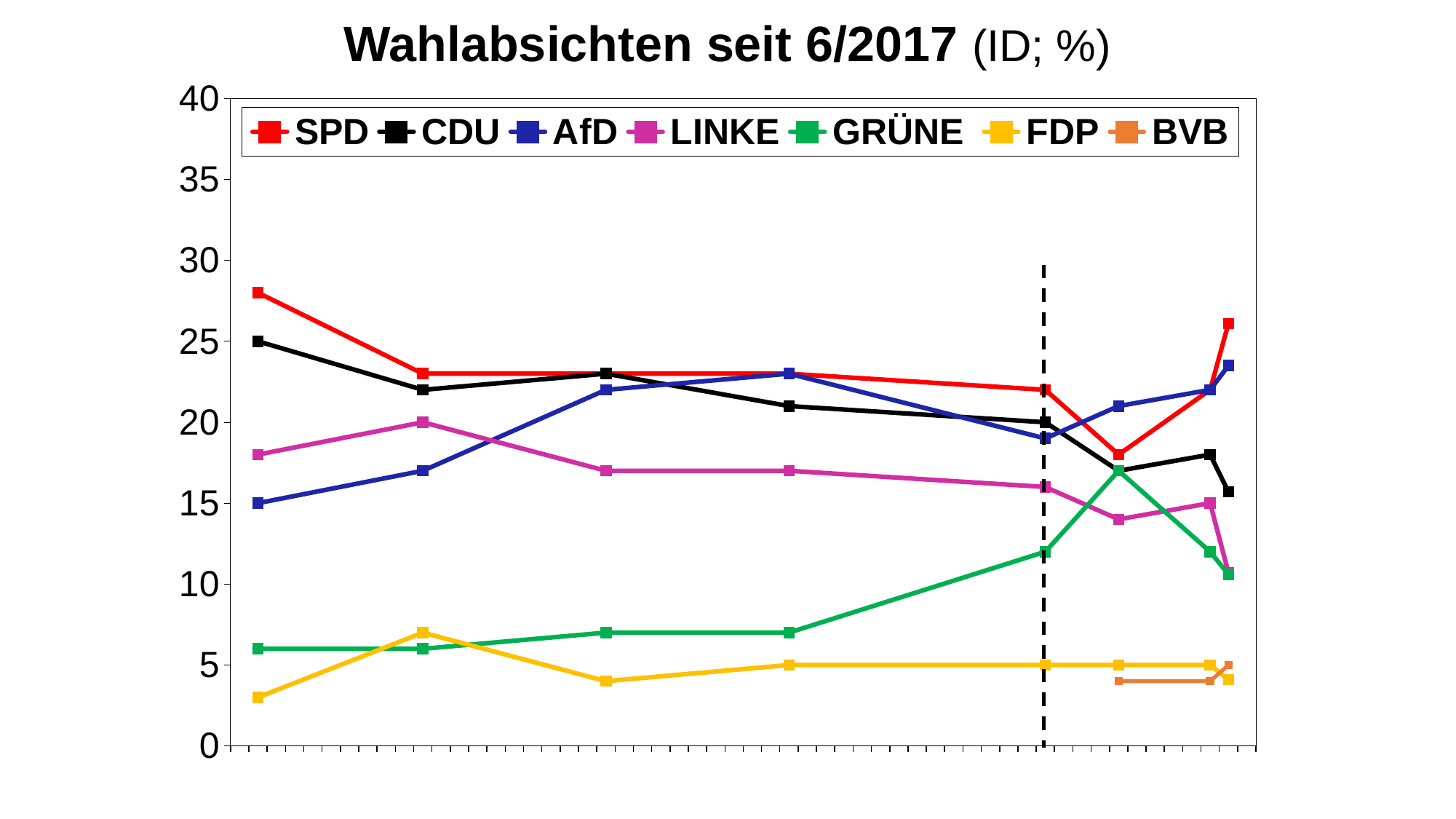
At the first point on the left, which is higher, SPD or CDU? SPD How many series does the legend list? 7 Does the GRÜNE line rise or fall from the first point up to the dashed vertical line? rise Is the last value for CDU greater or less than 20? less Is the first value for FDP greater or less than 5? less Which series has the highest value at the first point on the left? SPD Which series has the lowest value at the first point on the left? FDP Is the last value for AfD greater or less than 20? greater What is the title of the chart? Wahlabsichten seit 6/2017 (ID; %) What kind of chart is shown on the slide? line chart Which series is drawn in green? GRÜNE